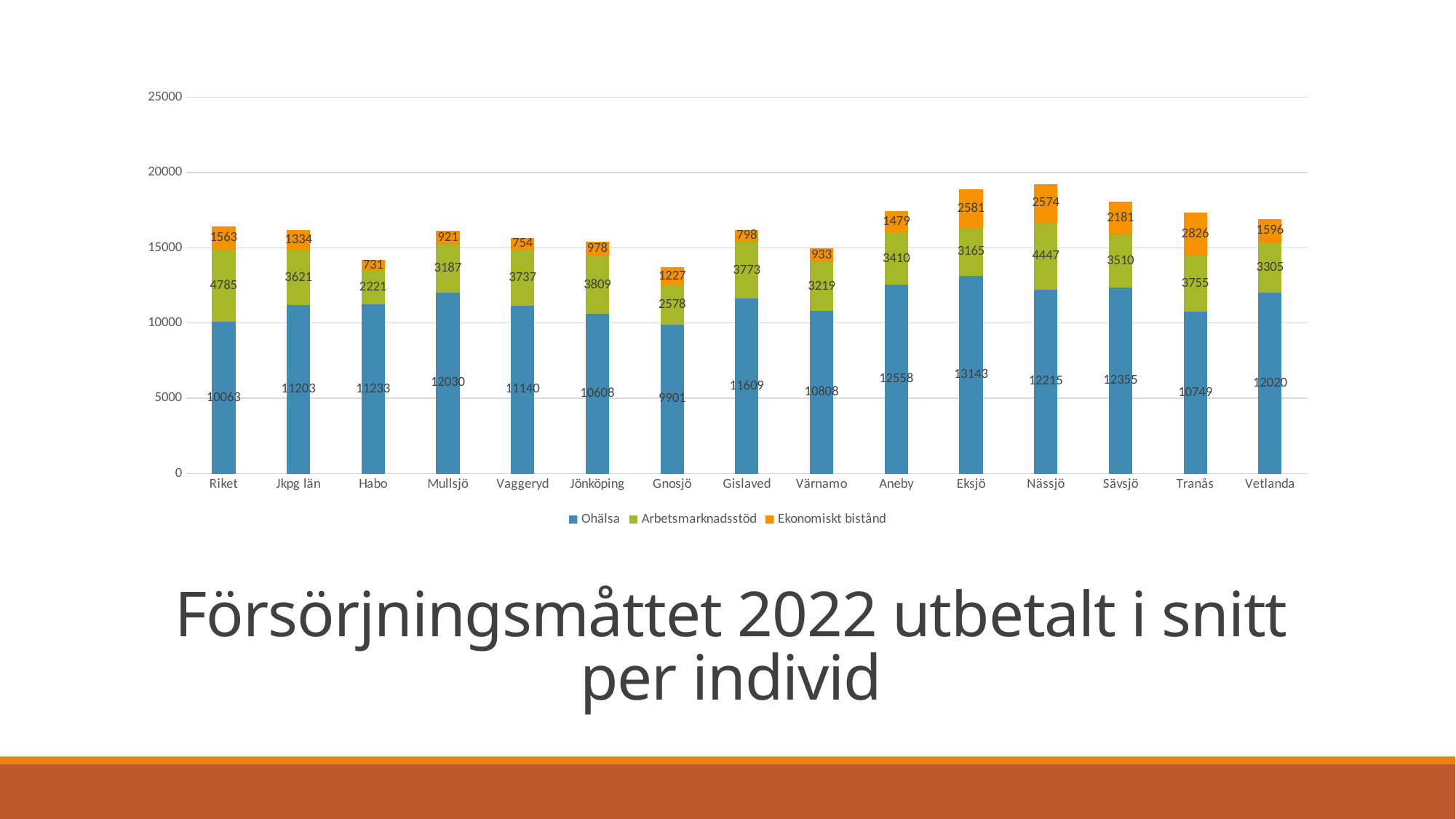
How many categories are shown on the x axis? 15 What is the Arbetsmarknadsstöd value for Riket? 4785 Which category has the lowest Ekonomiskt bistånd value? Habo Which category has the lowest Ohälsa value? Gnosjö What is the difference between the Ohälsa values for Eksjö and Gnosjö? 3242 How many series does the legend list? 3 What is the Ekonomiskt bistånd value for Tranås? 2826 What is the Ohälsa value for Eksjö? 13143 What kind of chart is shown on the slide? Stacked bar chart Which is larger, the Arbetsmarknadsstöd value for Riket or for Nässjö? Riket Which category has the highest Ohälsa value? Eksjö What is the total of the stacked bar for Habo? 14185